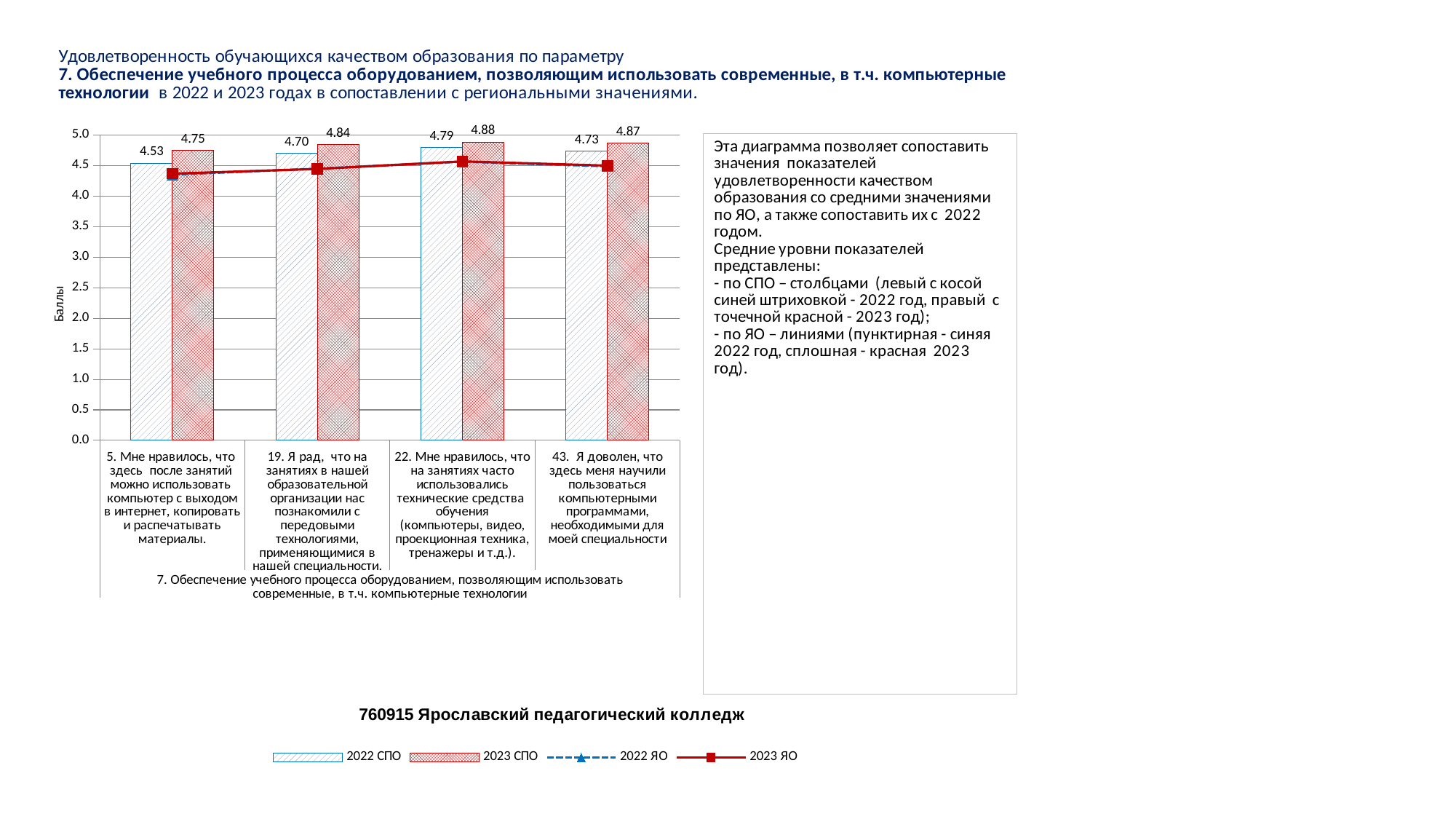
What is the 2022 СПО value for item 5 ("Мне нравилось, что здесь после занятий можно использовать компьютер...")? 4.53 Which item has the lowest 2023 СПО value? 5. Мне нравилось, что здесь после занятий можно использовать компьютер с выходом в интернет Which is larger for item 43: the 2022 СПО value or the 2023 СПО value? 2023 СПО What is the difference between the 2023 СПО and 2022 СПО values for item 19? 0.14 Is the 2023 ЯО line value for item 5 greater or less than 4.0? greater What is the label of the vertical axis? Баллы What is the 2023 СПО value for item 22 ("Мне нравилось, что на занятиях часто использовались технические средства обучения...")? 4.88 How many series does the legend list? 4 Which item has the highest 2022 СПО value? 22. Мне нравилось, что на занятиях часто использовались технические средства обучения How many items (categories) are shown on the x axis? 4 What is the difference between the 2023 СПО and 2022 СПО values for item 5? 0.22 What is the 2023 СПО value for item 43 ("Я доволен, что здесь меня научили пользоваться компьютерными программами...")? 4.87